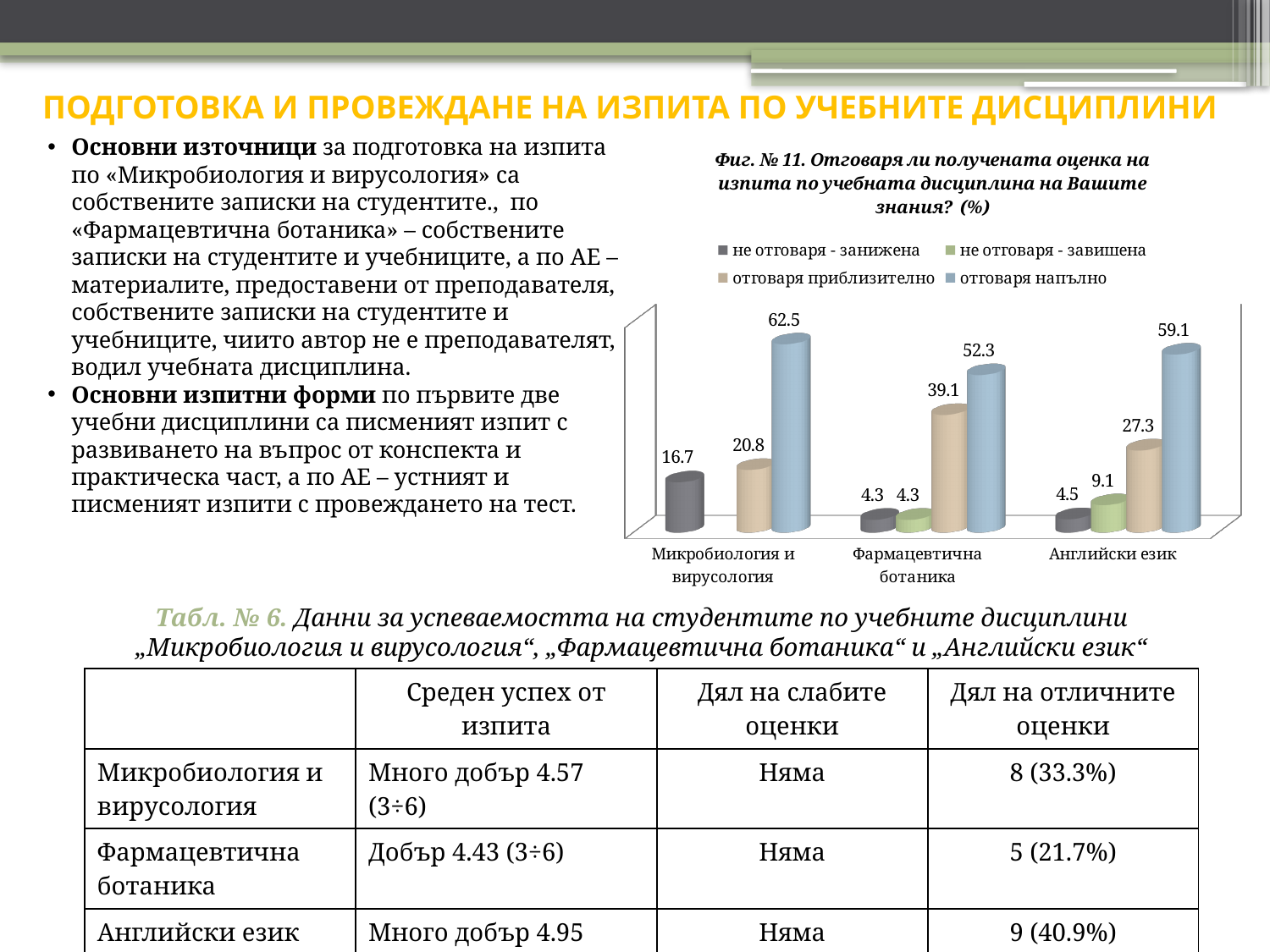
How many series does the chart legend list? 4 Which discipline has the lowest value for "отговаря приблизително"? Микробиология и вирусология What is the value for "не отговаря - завишена" for Английски език? 9.1 What is the value for "отговаря приблизително" for Фармацевтична ботаника? 39.1 What kind of chart is shown on the slide? Bar chart Which discipline has the highest value for "отговаря напълно"? Микробиология и вирусология Which is larger for Английски език: "отговаря приблизително" or "не отговаря - завишена"? отговаря приблизително What is the difference between the "отговаря напълно" values for Английски език and Фармацевтична ботаника? 6.8 What is the figure number of the chart on the slide? Фиг. № 11 What is the value for "не отговаря - занижена" for Микробиология и вирусология? 16.7 What is the value for "отговаря напълно" for Микробиология и вирусология? 62.5 How many disciplines are shown on the x axis of the chart? 3